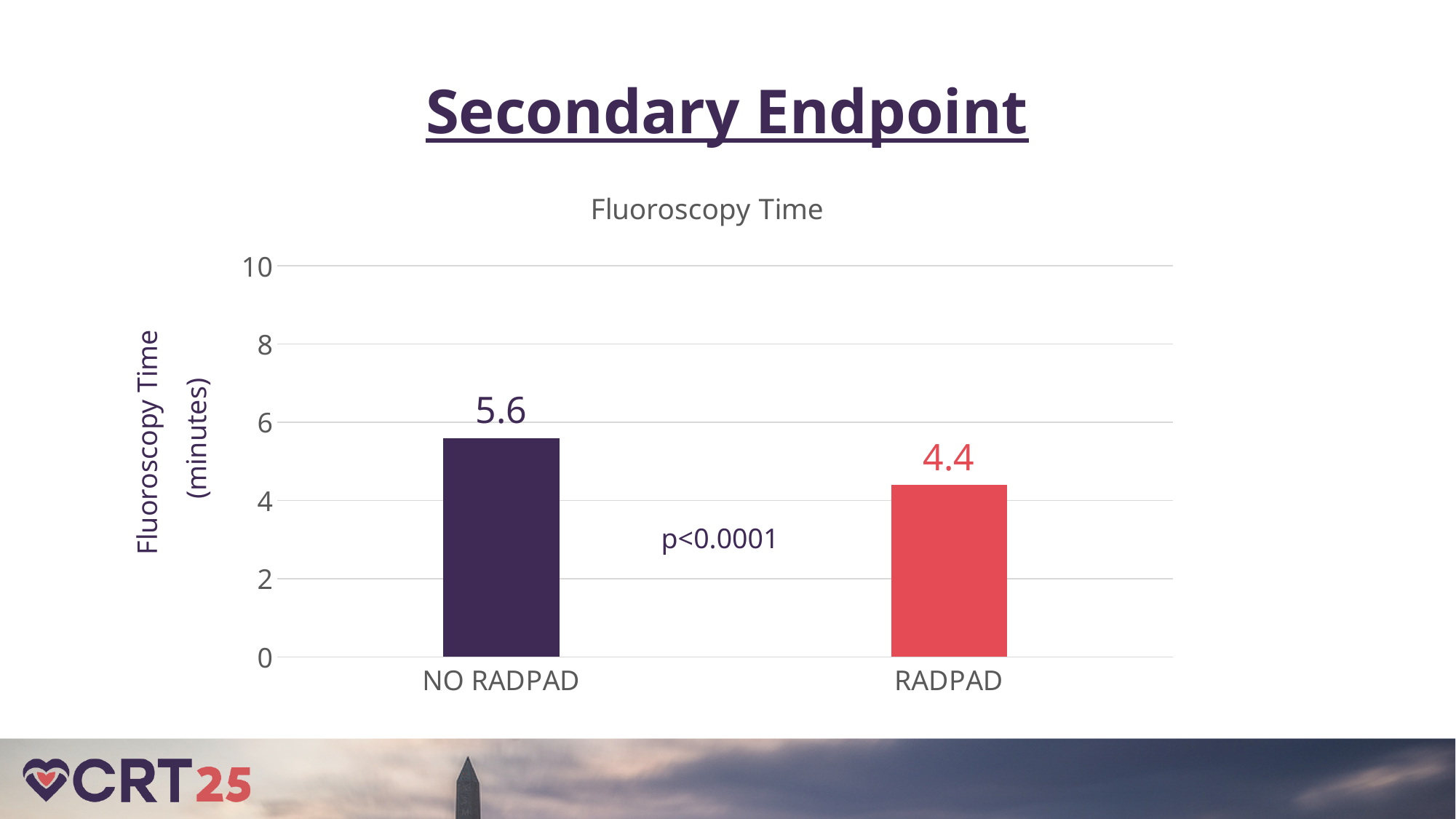
Is the value for NO RADPAD greater or less than 4? greater Is the fluoroscopy time for RADPAD larger or smaller than for NO RADPAD? smaller What is the fluoroscopy time for RADPAD? 4.4 How many categories are shown on the chart? 2 Which category has the lower fluoroscopy time? RADPAD What is the difference in fluoroscopy time between NO RADPAD and RADPAD? 1.2 What p-value is shown on the chart? p<0.0001 Is the value for RADPAD greater or less than 6? less Which category has the higher fluoroscopy time? NO RADPAD What is the title of the chart? Fluoroscopy Time What is the fluoroscopy time for NO RADPAD? 5.6 What kind of chart is shown on the slide? bar chart